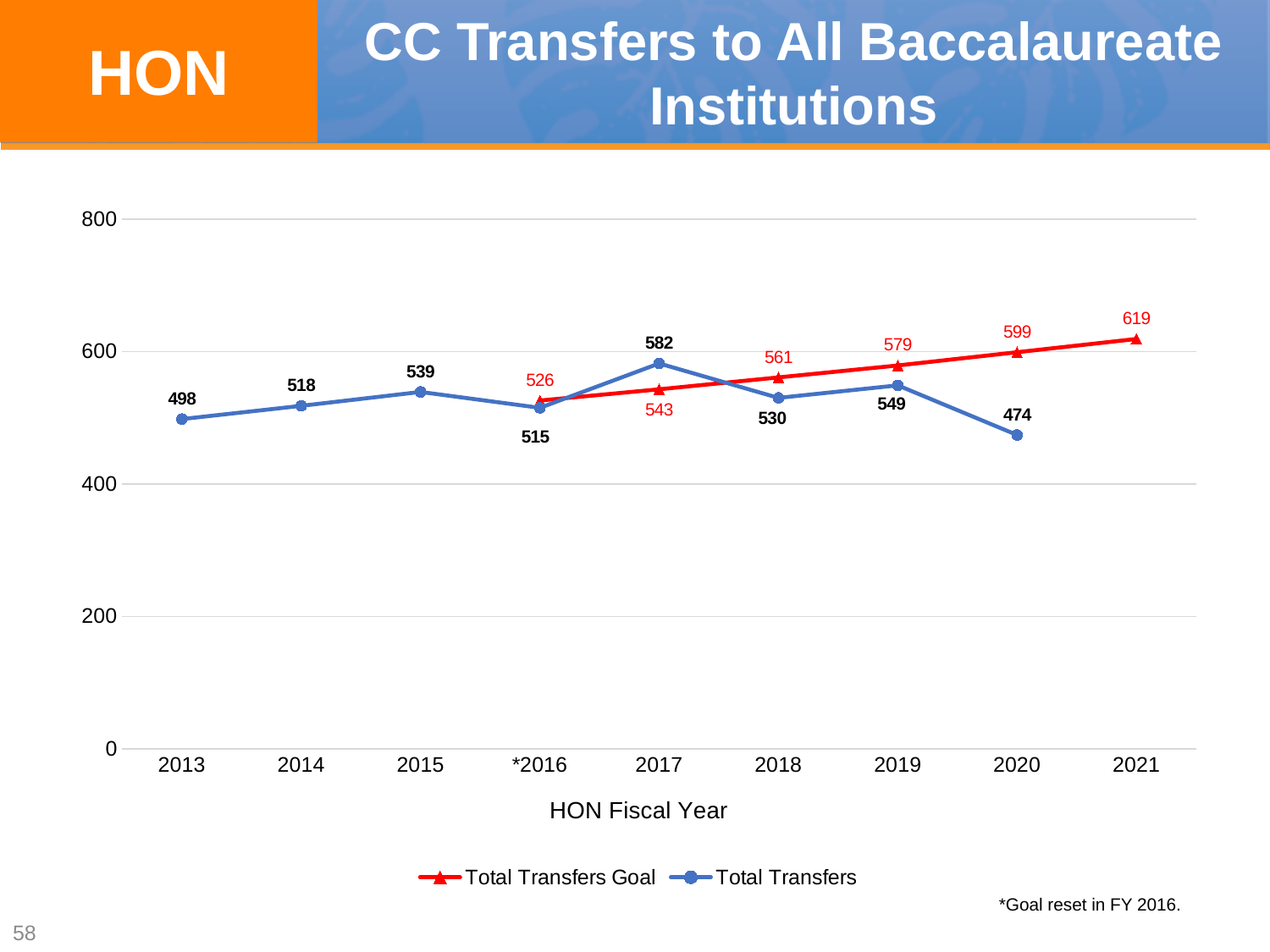
How many series does the legend list? 2 In which year is Total Transfers lowest? 2020 Is the Total Transfers value for 2018 greater or less than 600? less How many fiscal years are shown on the x axis? 9 In which year is Total Transfers highest? 2017 What kind of chart is shown? line chart What is the Total Transfers value for 2020? 474 Does the Total Transfers Goal series rise or fall from 2016 to 2021? rise What is the difference between the Total Transfers Goal and Total Transfers in 2019? 30 What is the Total Transfers value for 2013? 498 Which is larger in 2017, Total Transfers or Total Transfers Goal? Total Transfers What is the Total Transfers Goal value for 2021? 619